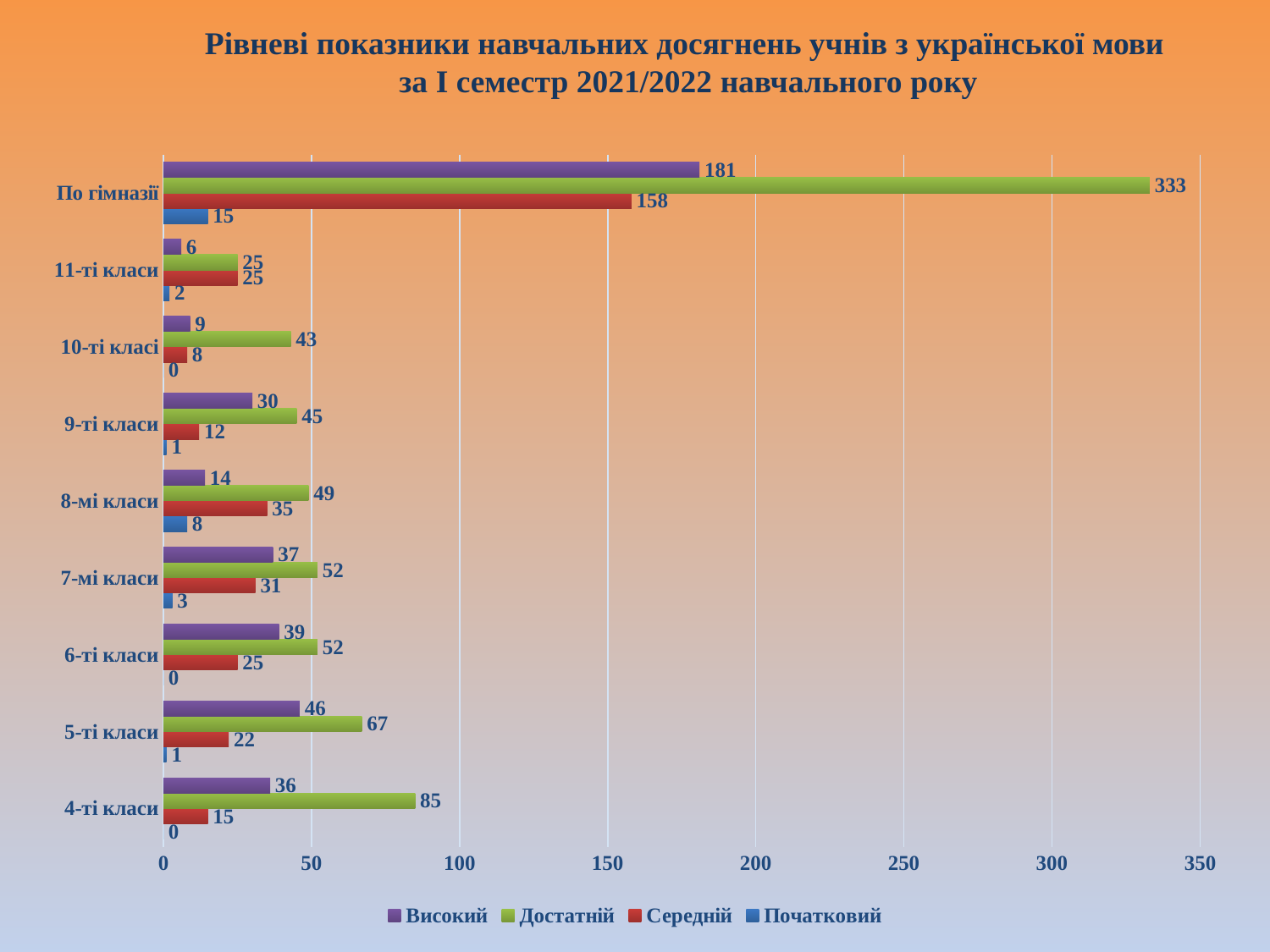
Which series is shown in green in the legend? Достатній What is the value of Високий for 5-ті класи? 46 How many series does the legend list? 4 What is the value of Початковий for 10-ті класі? 0 How many categories are shown on the vertical axis? 9 What type of chart is shown on the slide? bar chart What is the value of Достатній for По гімназії? 333 Which category has the lowest Високий value? 11-ті класи What is the difference between the Достатній and Середній values for По гімназії? 175 What is the value of Середній for 8-мі класи? 35 Which is larger for 9-ті класи: Високий or Середній? Високий Among the class categories (excluding По гімназії), which has the highest Достатній value? 4-ті класи